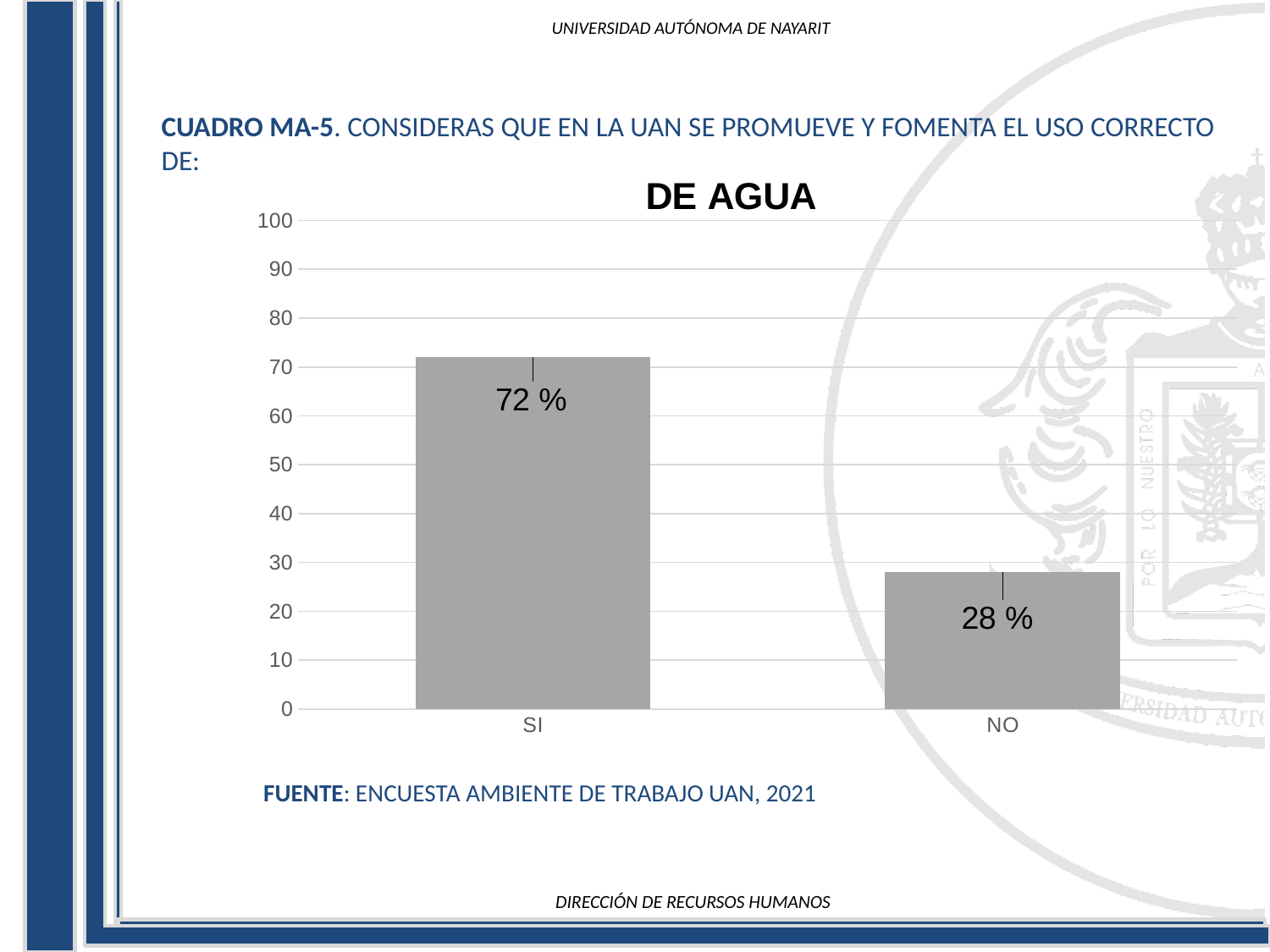
Which is larger, the value for SI or the value for NO? SI What is the difference between the values for SI and NO? 44 % What is the value for SI? 72 % What kind of chart is shown on the slide? bar chart Which category has the lowest value? NO What is the highest value shown on the y axis? 100 What is the value for NO? 28 % Is the value for SI greater or less than 50? greater How many categories are shown on the x axis? 2 Which category has the highest value? SI What is the title of the chart? DE AGUA Is the value for NO greater or less than 30? less